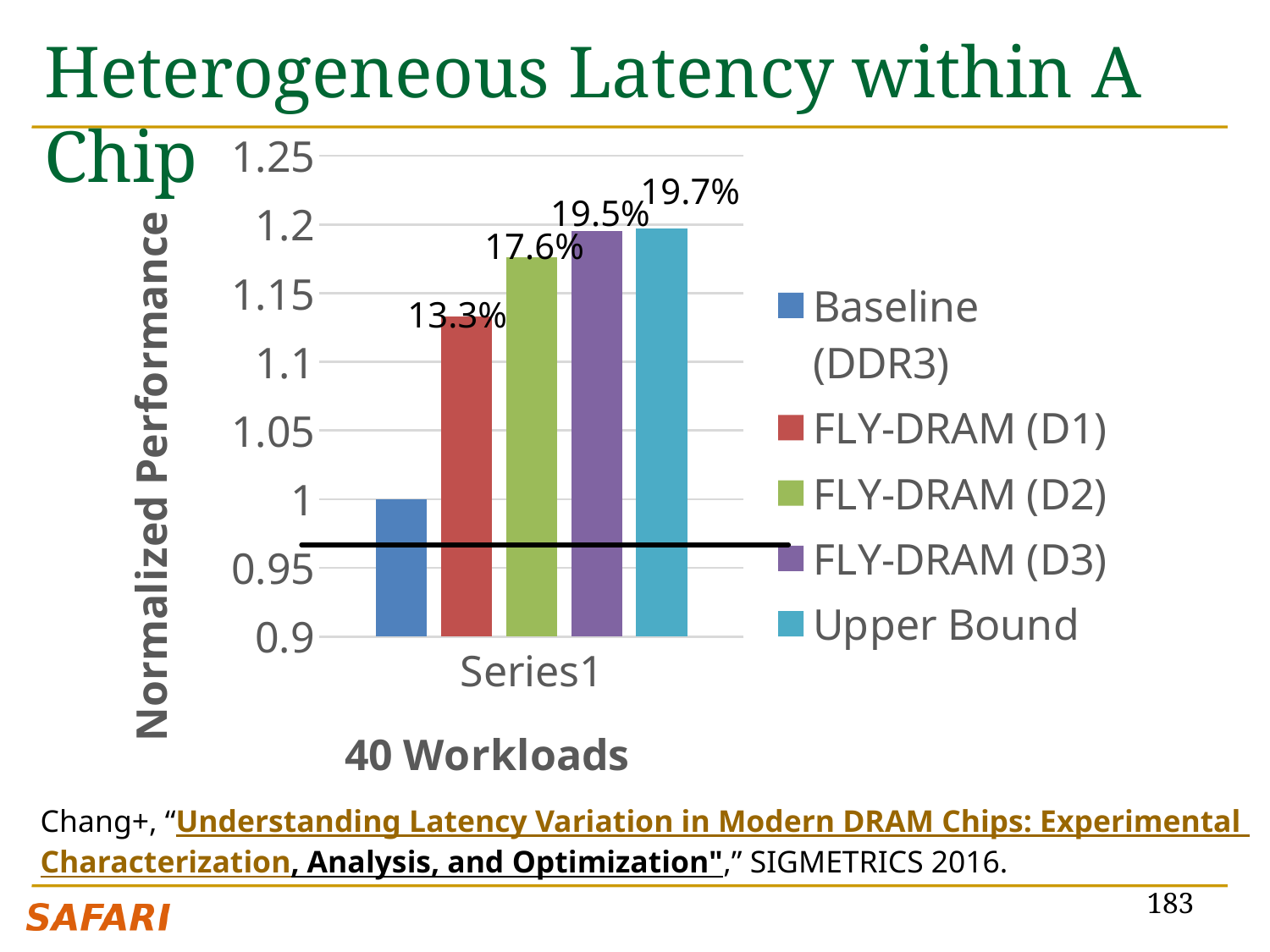
What data label is shown on the Upper Bound bar? 19.7% What data label is shown on the FLY-DRAM (D3) bar? 19.5% Is the normalized performance for FLY-DRAM (D1) greater or less than 1.1? greater How many series does the legend list? 5 Which series has the shortest bar? Baseline (DDR3) What is the difference between the data labels on the Upper Bound bar and the FLY-DRAM (D1) bar? 6.4 percentage points Which bar is taller, FLY-DRAM (D3) or FLY-DRAM (D2)? FLY-DRAM (D3) What normalized performance value does the Baseline (DDR3) bar reach on the y axis? 1 What data label is shown on the FLY-DRAM (D2) bar? 17.6% Which series has the tallest bar? Upper Bound What kind of chart is shown on the slide? bar chart What data label is shown on the FLY-DRAM (D1) bar? 13.3%